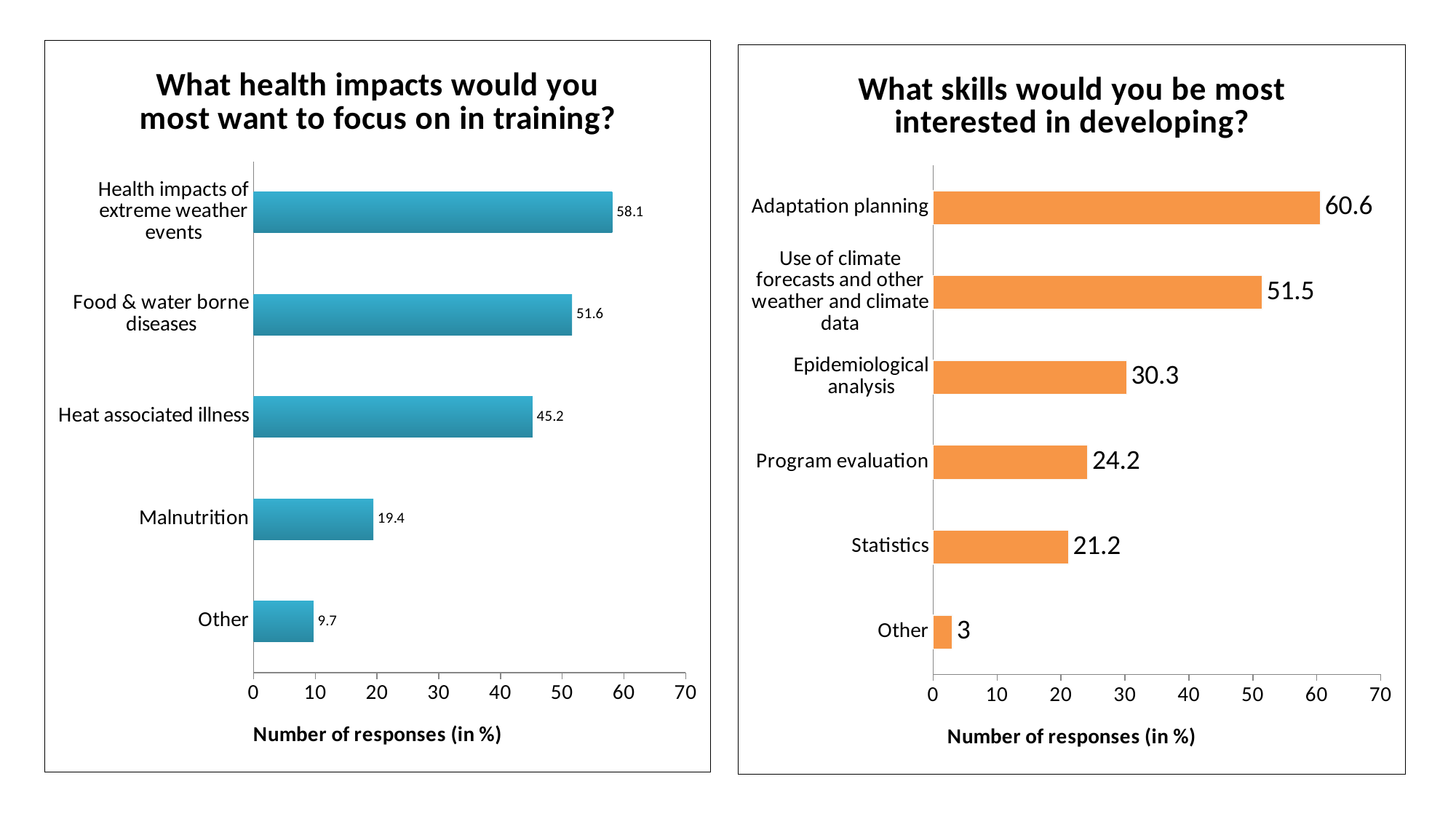
In the chart titled 'What skills would you be most interested in developing?', which is larger: Epidemiological analysis or Statistics? Epidemiological analysis In the chart titled 'What skills would you be most interested in developing?', what is the difference between the values for Adaptation planning and Use of climate forecasts and other weather and climate data? 9.1 In the chart titled 'What health impacts would you most want to focus on in training?', which category has the lowest value? Other In the chart titled 'What skills would you be most interested in developing?', what is the value for Program evaluation? 24.2 In the chart titled 'What health impacts would you most want to focus on in training?', which category has the highest value? Health impacts of extreme weather events What kind of chart is the chart on the right of the slide? Bar chart What is the x-axis title of the chart titled 'What health impacts would you most want to focus on in training?'? Number of responses (in %) In the chart titled 'What health impacts would you most want to focus on in training?', what is the value for Heat associated illness? 45.2 In the chart titled 'What skills would you be most interested in developing?', which category has the highest value? Adaptation planning In the chart titled 'What skills would you be most interested in developing?', how many categories are shown? 6 In the chart titled 'What health impacts would you most want to focus on in training?', how many categories are shown? 5 In the chart titled 'What health impacts would you most want to focus on in training?', what is the difference between the values for Food & water borne diseases and Malnutrition? 32.2